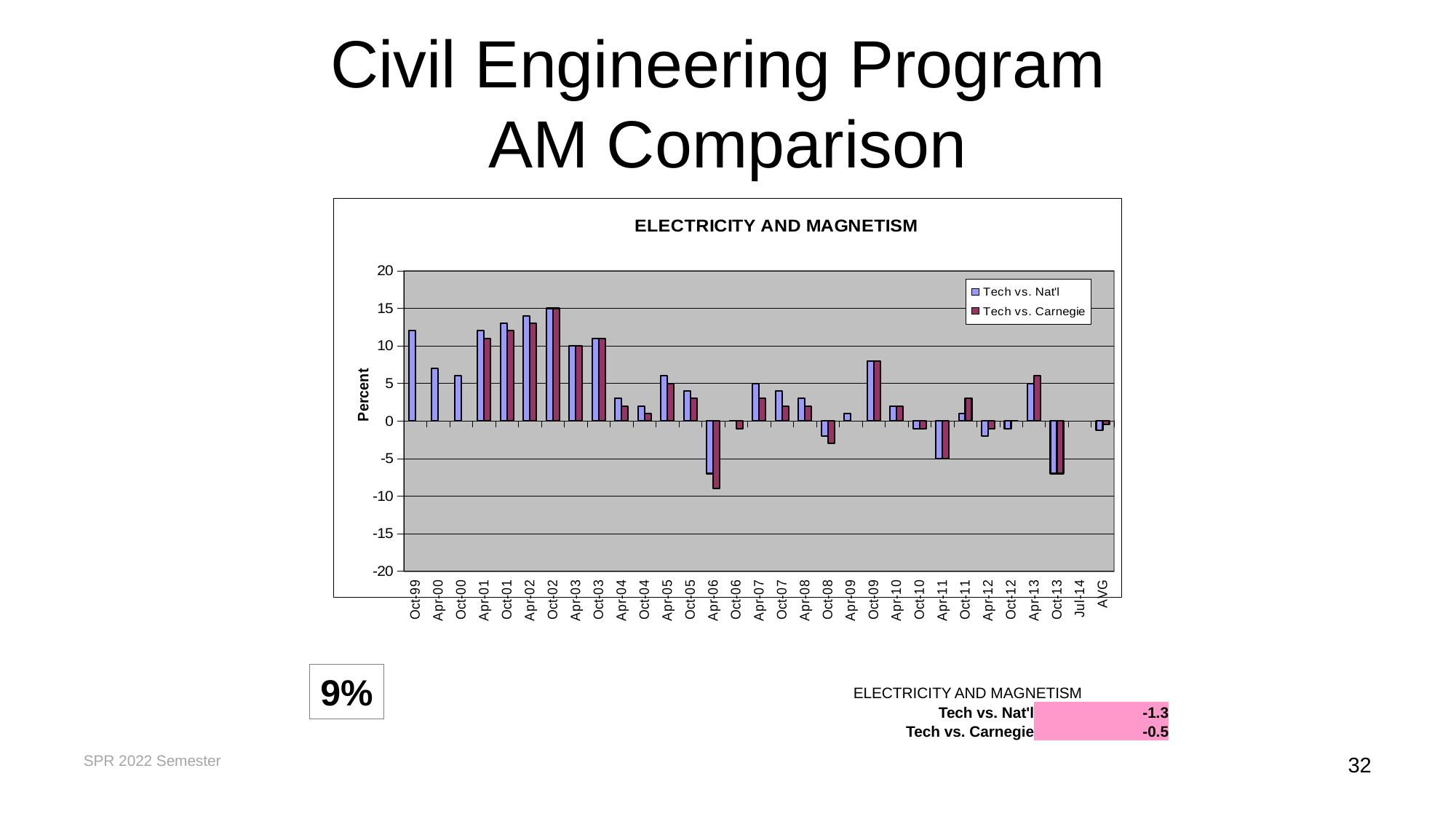
What is the label on the vertical axis of the chart? Percent Which period has the lowest Tech vs. Carnegie value? Apr-06 Is the Tech vs. Nat'l value for Apr-11 greater or less than 0? less What is the title of the chart? ELECTRICITY AND MAGNETISM Is the Tech vs. Carnegie value for Apr-06 greater or less than -5? less For Apr-06, which series has the lower value, Tech vs. Nat'l or Tech vs. Carnegie? Tech vs. Carnegie How many categories are shown along the x axis of the chart? 31 What kind of chart is shown on the slide? bar chart How many series does the chart's legend list? 2 What is the Tech vs. Nat'l value for Oct-02? 15 Do the Tech vs. Nat'l values generally rise or fall from Oct-02 to Apr-06? fall Is the Tech vs. Nat'l value for Oct-99 greater or less than 10? greater